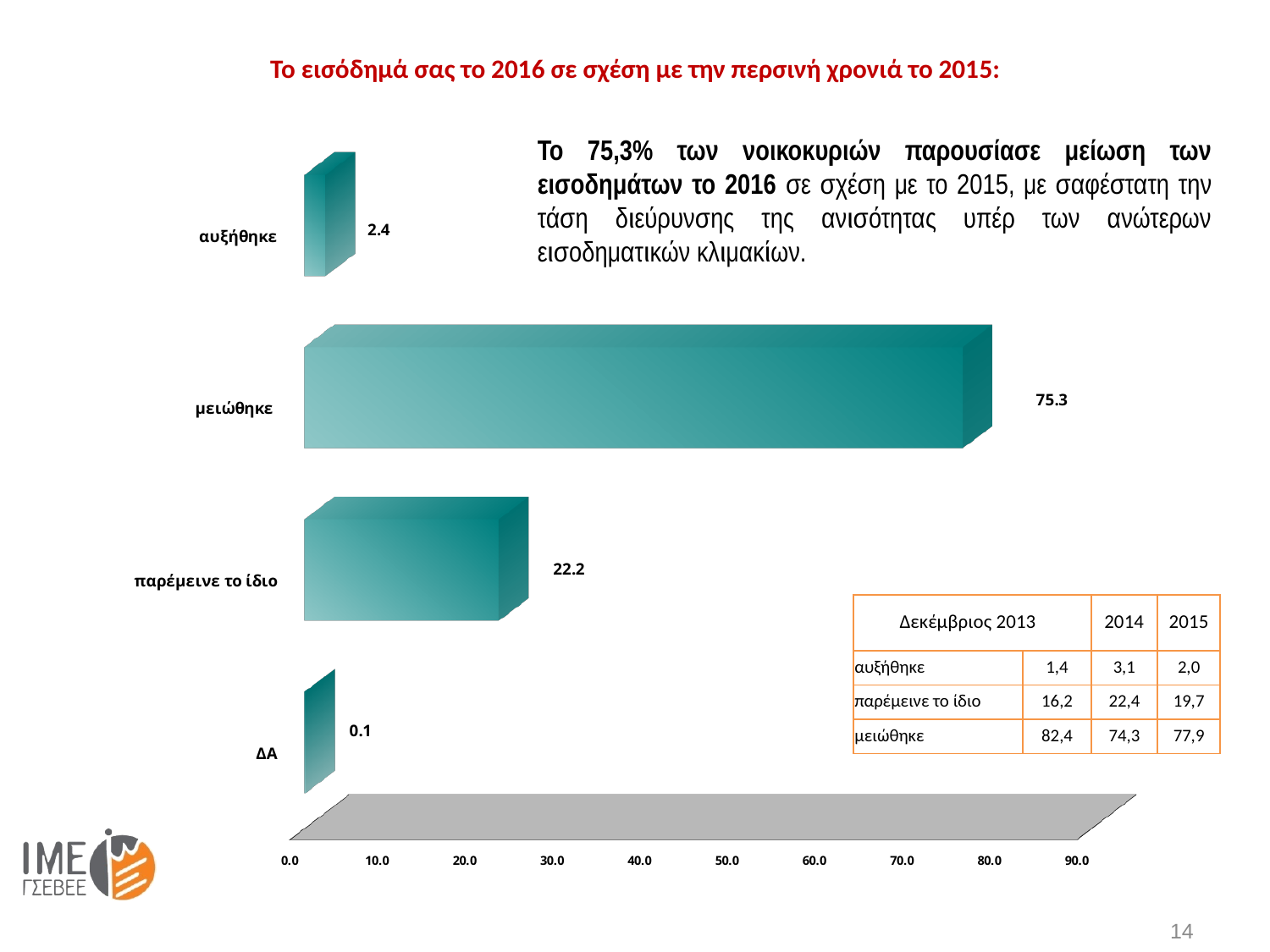
Which category has the lowest value? ΔΑ What kind of chart is shown on the slide? bar chart How many categories are shown in the chart? 4 What is the value for "μειώθηκε"? 75.3 What is the value for "ΔΑ"? 0.1 What is the difference between the values for "μειώθηκε" and "παρέμεινε το ίδιο"? 53.1 What is the value for "αυξήθηκε"? 2.4 Is the value for "μειώθηκε" greater or less than 70.0? greater Which category has the highest value? μειώθηκε What is the title of the chart? Το εισόδημά σας το 2016 σε σχέση με την περσινή χρονιά το 2015: Which is larger, the value for "αυξήθηκε" or the value for "παρέμεινε το ίδιο"? παρέμεινε το ίδιο What is the value for "παρέμεινε το ίδιο"? 22.2